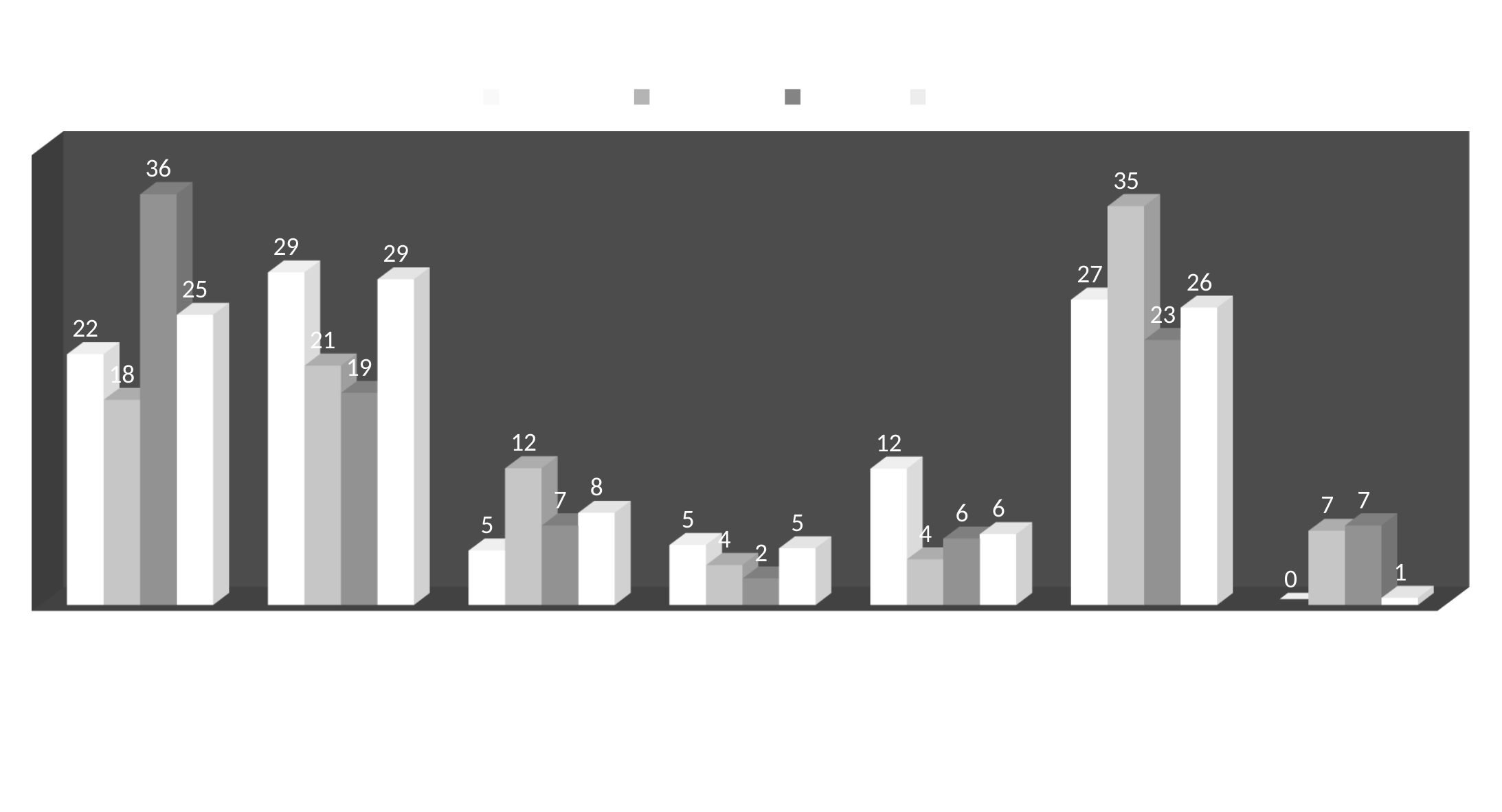
How many series does the legend list? 4 What kind of chart is shown on the slide? bar chart What is the difference between the highest data label (36) and the second-highest data label (35) on the chart? 1 What is the highest data label value shown on the chart? 36 How many bars are plotted in total on the chart? 28 How many groups of bars are plotted along the x axis? 7 What is the lowest data label value shown on the chart? 0